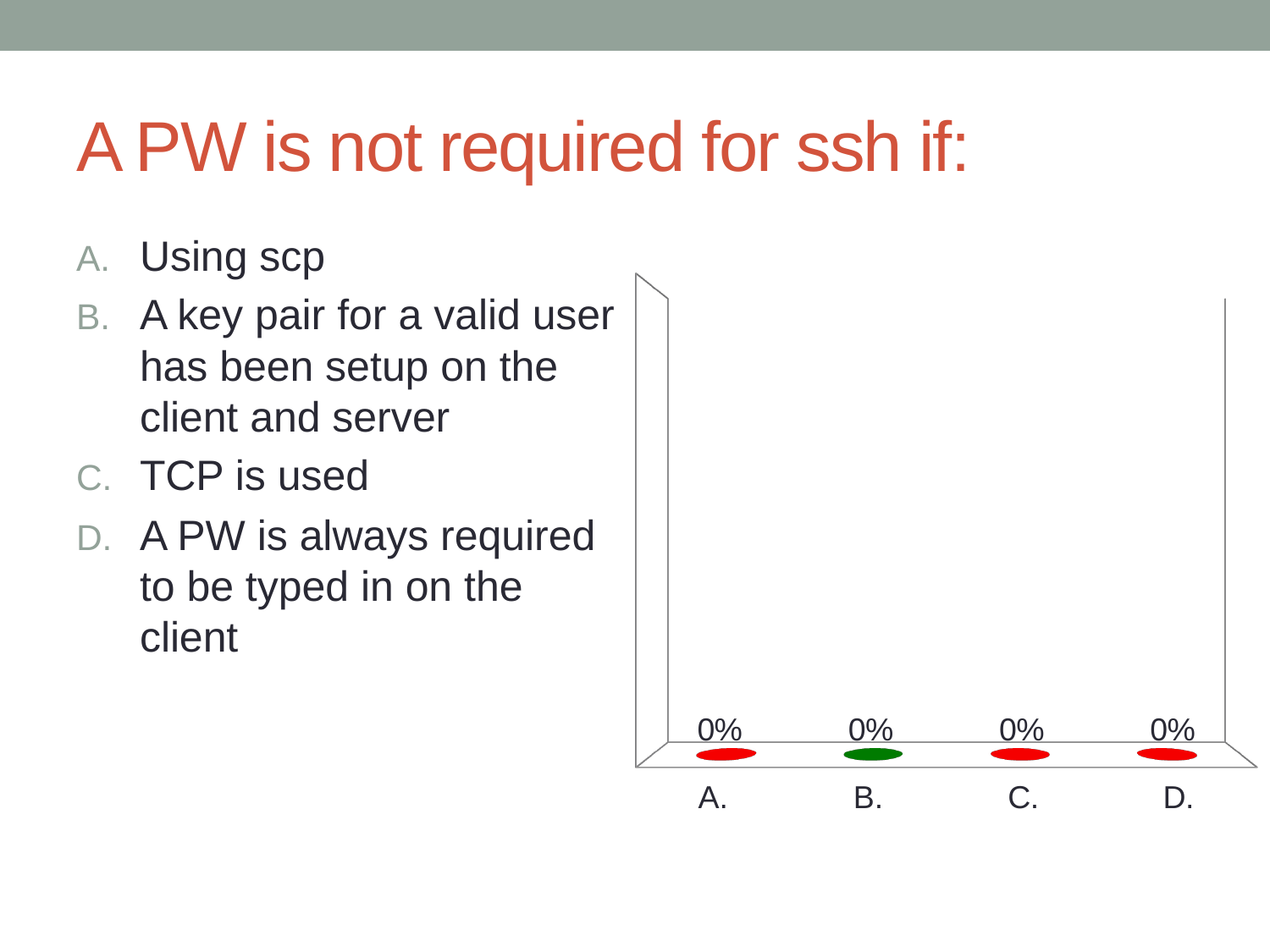
What are the category labels along the x axis of the chart? A., B., C., D. What kind of chart is shown on the slide? Bar chart What is the difference between the values for A. and D. in the chart? 0% How many categories are plotted in the chart? 4 What is the difference between the values for B. and C. in the chart? 0% What is the value shown for category C. in the chart? 0% What is the value shown for category A. in the chart? 0% Which category's bar base is coloured green in the chart? B. What is the value shown for category B. in the chart? 0% What is the value shown for category D. in the chart? 0%